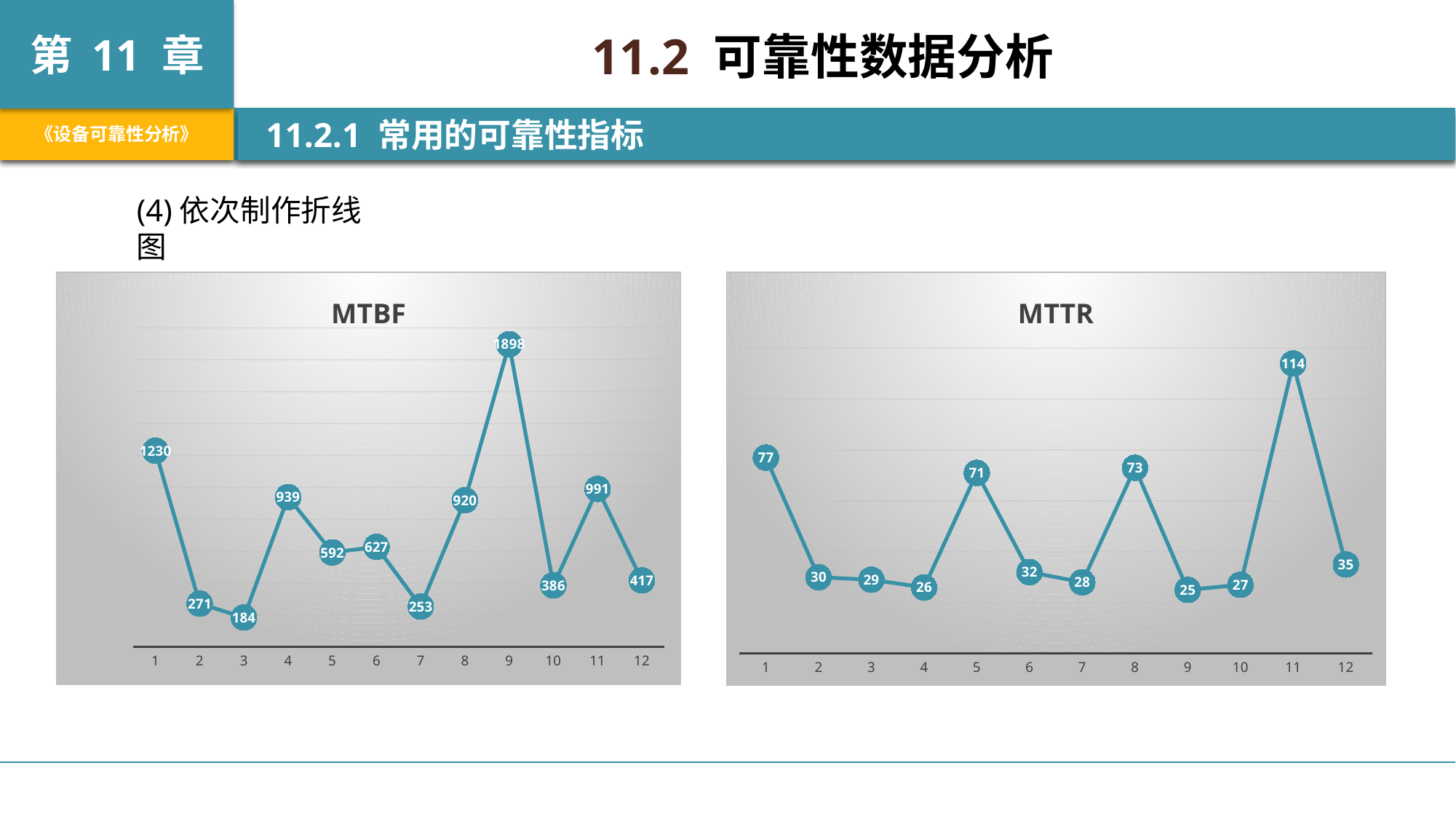
In the MTBF chart, what is the value at point 1? 1230 In the MTBF chart, which point has the lowest value? 3 In the MTBF chart, how many points are plotted? 12 What kind of chart is the MTTR chart? Line chart In the MTBF chart, what is the difference between the values at point 9 and point 1? 668 In the MTTR chart, what is the value at point 5? 71 In the MTTR chart, which point has the lowest value? 9 In the MTBF chart, which is larger, the value at point 4 or the value at point 11? Point 11 In the MTTR chart, does the value rise or fall from point 11 to point 12? Fall In the MTBF chart, what is the value at point 9? 1898 In the MTTR chart, what is the difference between the values at point 8 and point 7? 45 In the MTTR chart, what is the value at point 11? 114